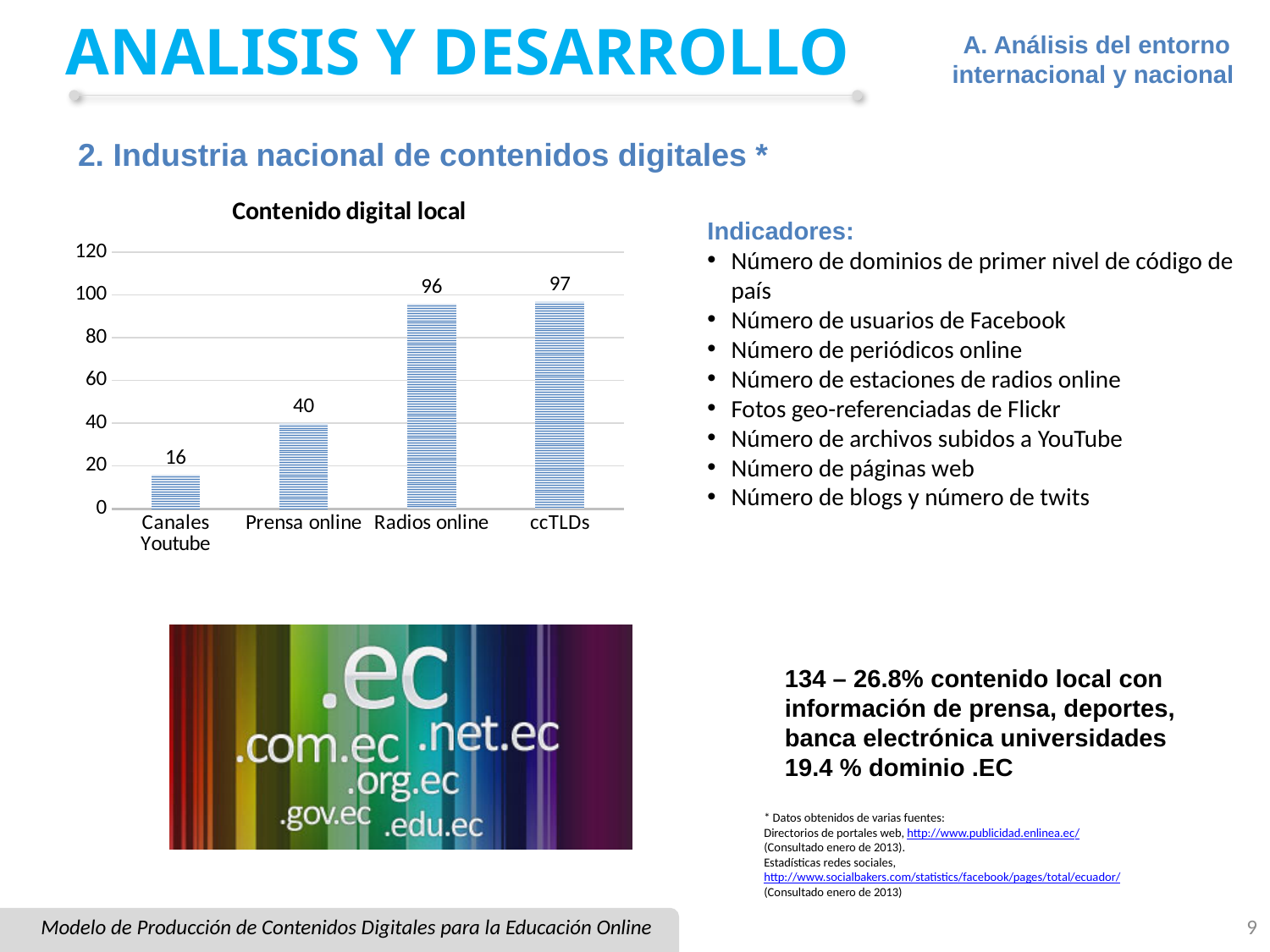
How many categories are shown in the Contenido digital local chart? 4 What is the difference between the values for Radios online and Prensa online in the Contenido digital local chart? 56 What is the value for Canales Youtube in the Contenido digital local chart? 16 What is the value for Prensa online in the Contenido digital local chart? 40 What is the title of the chart on the slide? Contenido digital local Which category has the highest value in the Contenido digital local chart? ccTLDs Which category has the lowest value in the Contenido digital local chart? Canales Youtube What is the difference between the values for Prensa online and Canales Youtube in the Contenido digital local chart? 24 What is the value for Radios online in the Contenido digital local chart? 96 What kind of chart is the Contenido digital local chart? Bar chart What is the value for ccTLDs in the Contenido digital local chart? 97 Which is larger in the Contenido digital local chart, Prensa online or Radios online? Radios online